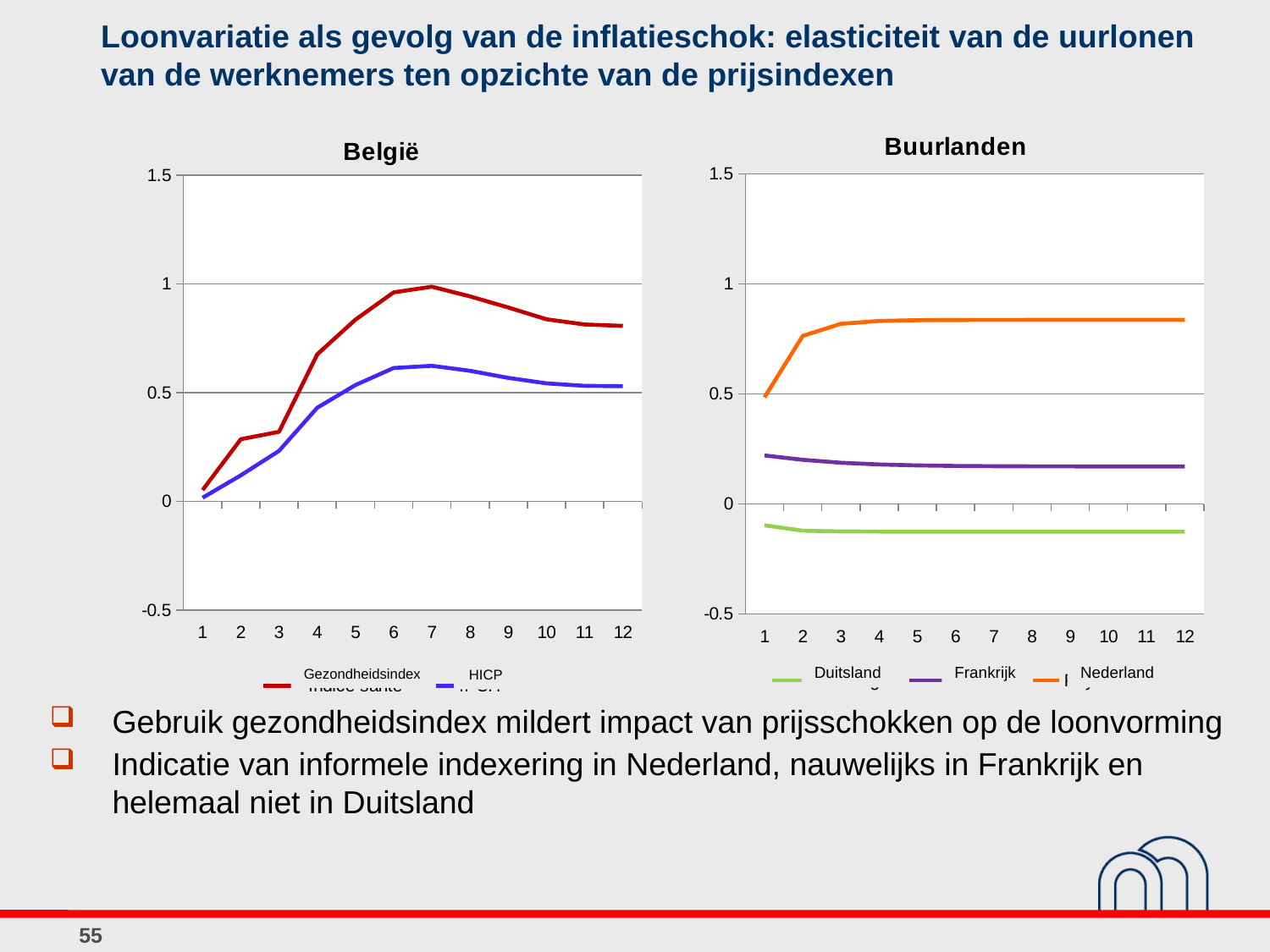
In the 'Buurlanden' chart, which series has the highest value at period 12? Nederland In the 'Buurlanden' chart, is the value for Nederland at period 12 greater or less than 0.5? greater What kind of chart is the 'België' chart? line chart In the 'Buurlanden' chart, which series has the lowest value at period 12? Duitsland In the 'België' chart, which series has the larger value at period 7, Gezondheidsindex or HICP? Gezondheidsindex In the 'België' chart, does the Gezondheidsindex line rise or fall between period 1 and period 7? rise How many periods are shown on the x axis of the 'Buurlanden' chart? 12 How many series does the legend of the 'Buurlanden' chart list? 3 How many series does the legend of the 'België' chart list? 2 In the 'Buurlanden' chart, is the value for Duitsland at period 12 greater or less than 0? less In the 'België' chart, is the value of Gezondheidsindex at period 7 greater or less than 0.5? greater